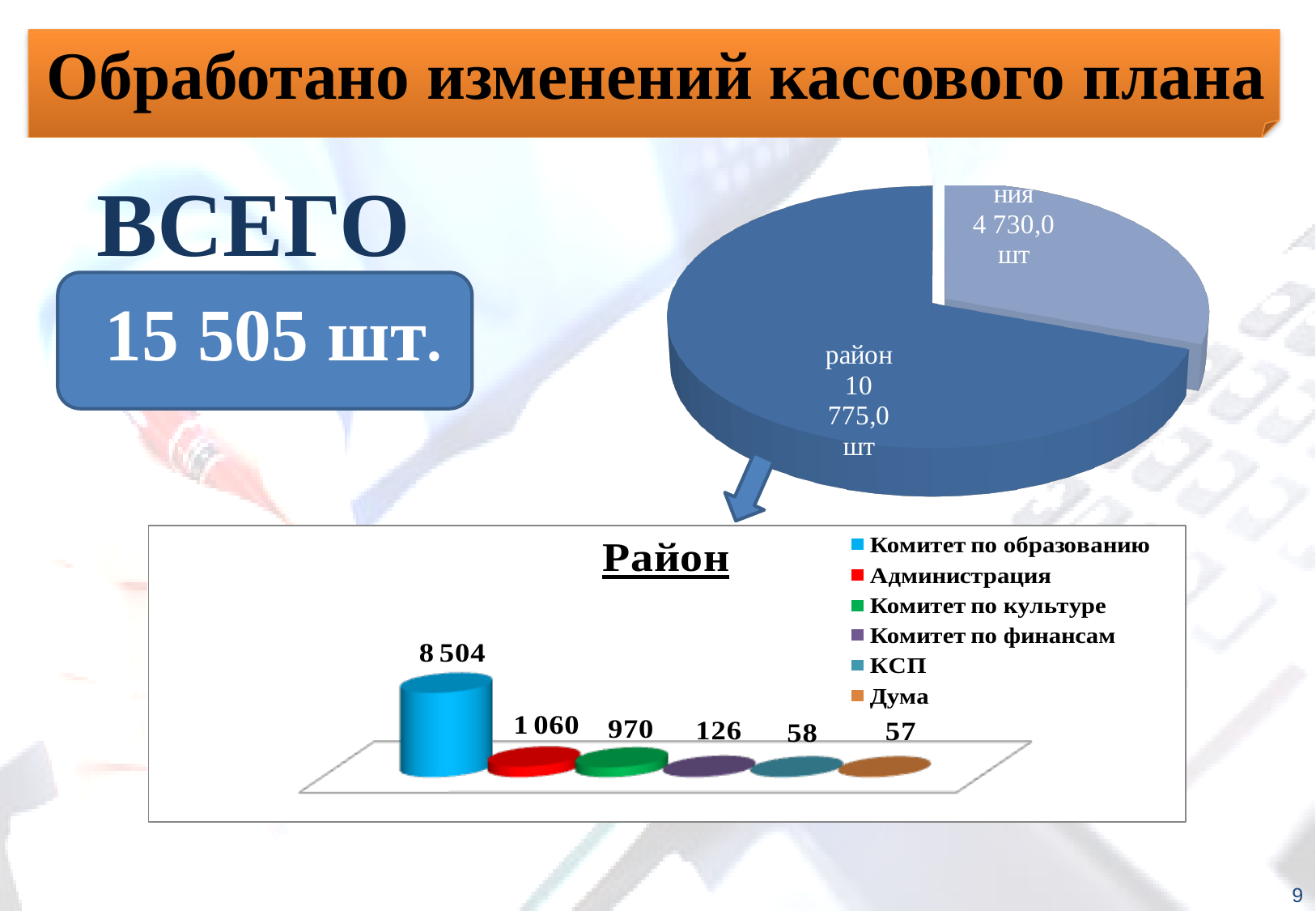
In the pie chart, which slice is larger, the район slice or the lighter slice? район In the Район chart, what is the difference between the values for Комитет по образованию and Администрация? 7 444 In the pie chart, what value is shown for the район slice? 10 775,0 шт What kind of chart is the chart in the upper right of the slide? pie chart In the Район chart, what is the value for Администрация? 1 060 How many slices does the pie chart have? 2 In the Район chart, which is larger, Комитет по культуре or Комитет по финансам? Комитет по культуре How many series does the legend of the Район chart list? 6 In the Район chart, what is the value for Комитет по образованию? 8 504 In the Район chart, which series has the highest value? Комитет по образованию In the Район chart, what is the value for Дума? 57 What kind of chart is the Район chart at the bottom of the slide? bar chart